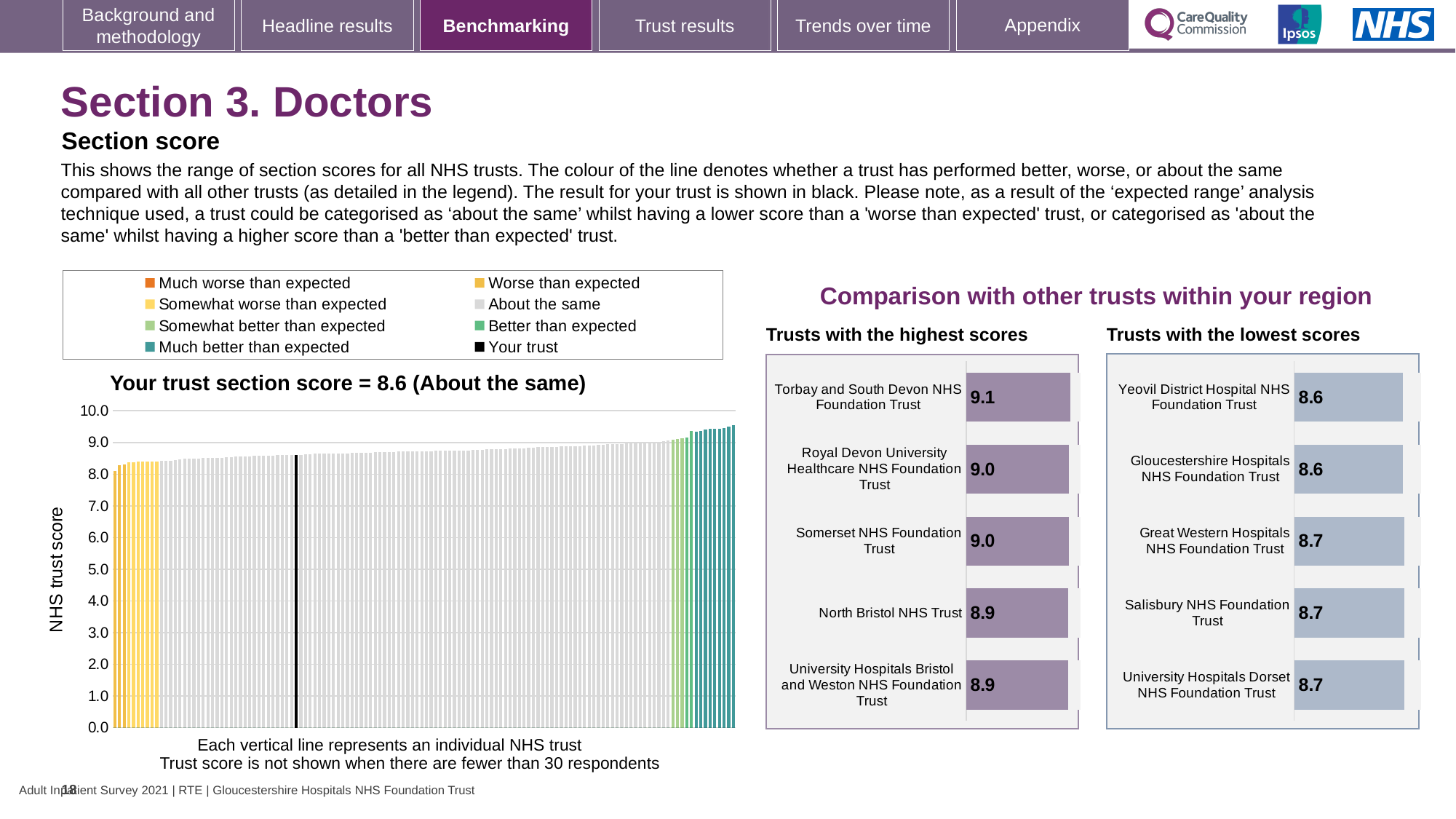
In the 'Trusts with the lowest scores' chart, what is the score for Yeovil District Hospital NHS Foundation Trust? 8.6 In the 'Trusts with the lowest scores' chart, what is the difference between the scores of University Hospitals Dorset NHS Foundation Trust and Gloucestershire Hospitals NHS Foundation Trust? 0.1 In the 'Trusts with the highest scores' chart, which trust has the highest score? Torbay and South Devon NHS Foundation Trust What kind of chart is the 'Your trust section score' chart? bar chart In the 'Trusts with the lowest scores' chart, what is the score for Salisbury NHS Foundation Trust? 8.7 In the 'Your trust section score' chart, what is the section score for your trust? 8.6 In the 'Trusts with the highest scores' chart, what is the difference between the scores of Torbay and South Devon NHS Foundation Trust and North Bristol NHS Trust? 0.2 In the 'Trusts with the highest scores' chart, what is the score for North Bristol NHS Trust? 8.9 In the 'Trusts with the lowest scores' chart, which is larger: the score for Great Western Hospitals NHS Foundation Trust or Yeovil District Hospital NHS Foundation Trust? Great Western Hospitals NHS Foundation Trust In the 'Trusts with the highest scores' chart, what is the score for Torbay and South Devon NHS Foundation Trust? 9.1 In the 'Your trust section score' chart, do the trust scores rise or fall from left to right along the x axis? rise How many trusts are shown in the 'Trusts with the highest scores' chart? 5